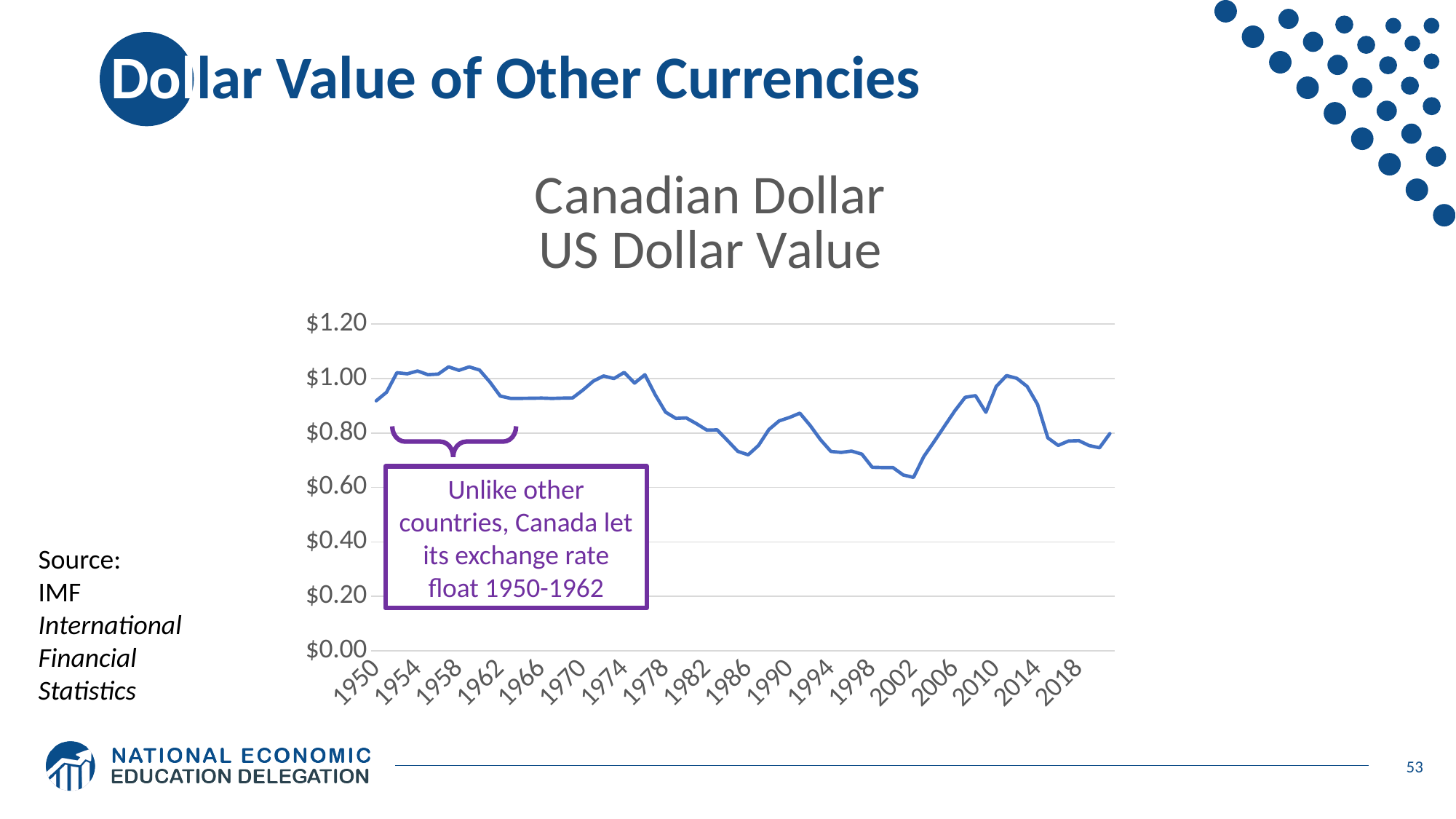
Is the value for 1958 greater or less than $1.00? greater Is the value for 2002 greater or less than $0.80? less Is the value for 2010 greater or less than $0.80? greater Which year has the larger value, 1958 or 2002? 1958 Do the values rise or fall between 1974 and 1986? fall What kind of chart is shown on the slide? Line chart According to the annotation on the chart, during which years did Canada let its exchange rate float? 1950-1962 Do the values rise or fall between 2002 and 2010? rise What is the title of the chart? Canadian Dollar US Dollar Value